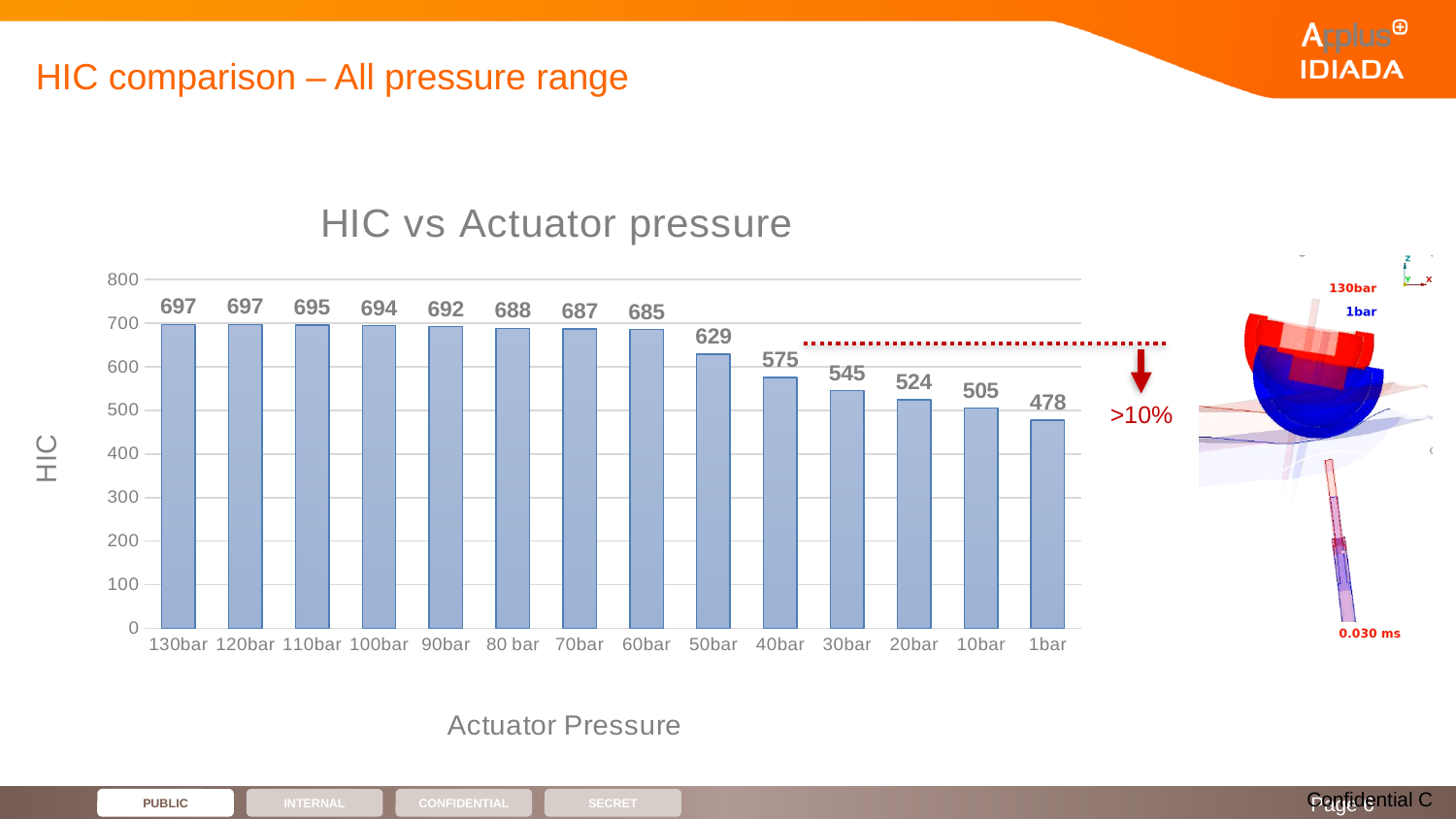
Is the HIC value at 10bar greater or less than 600? less What is the difference in HIC between 50bar and 40bar? 54 Which actuator pressure has the lowest HIC value? 1bar What is the HIC value at 1bar actuator pressure? 478 How many actuator pressure categories are shown on the x axis? 14 What is the title of the chart? HIC vs Actuator pressure What is the difference in HIC between 130bar and 1bar? 219 Which has a higher HIC value, 30bar or 20bar? 30bar What is the HIC value at 50bar actuator pressure? 629 Do the HIC values rise or fall as actuator pressure decreases from 130bar to 1bar along the x axis? fall What is the HIC value at 90bar actuator pressure? 692 What type of chart is shown? bar chart